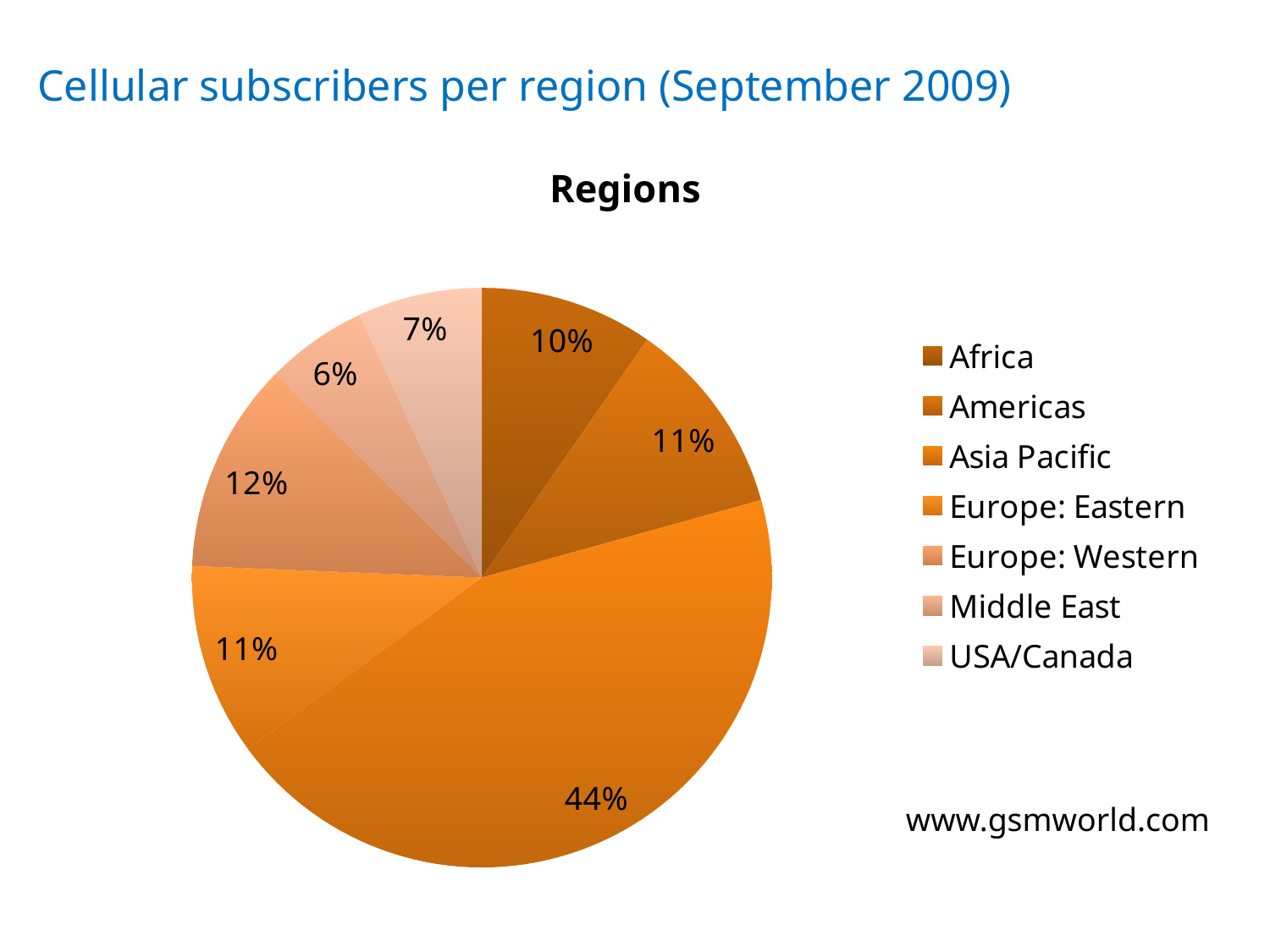
What share of cellular subscribers does the Middle East have? 6% What share of cellular subscribers does USA/Canada have? 7% What is the title of the chart? Regions What share of cellular subscribers does Africa have? 10% How many regions does the legend list? 7 Which has the larger share, USA/Canada or Middle East? USA/Canada What is the difference in percentage points between the Asia Pacific share and the Europe: Western share? 32 Which region has the largest share of cellular subscribers? Asia Pacific Which region has the smallest share of cellular subscribers? Middle East What kind of chart is shown on the slide? pie chart